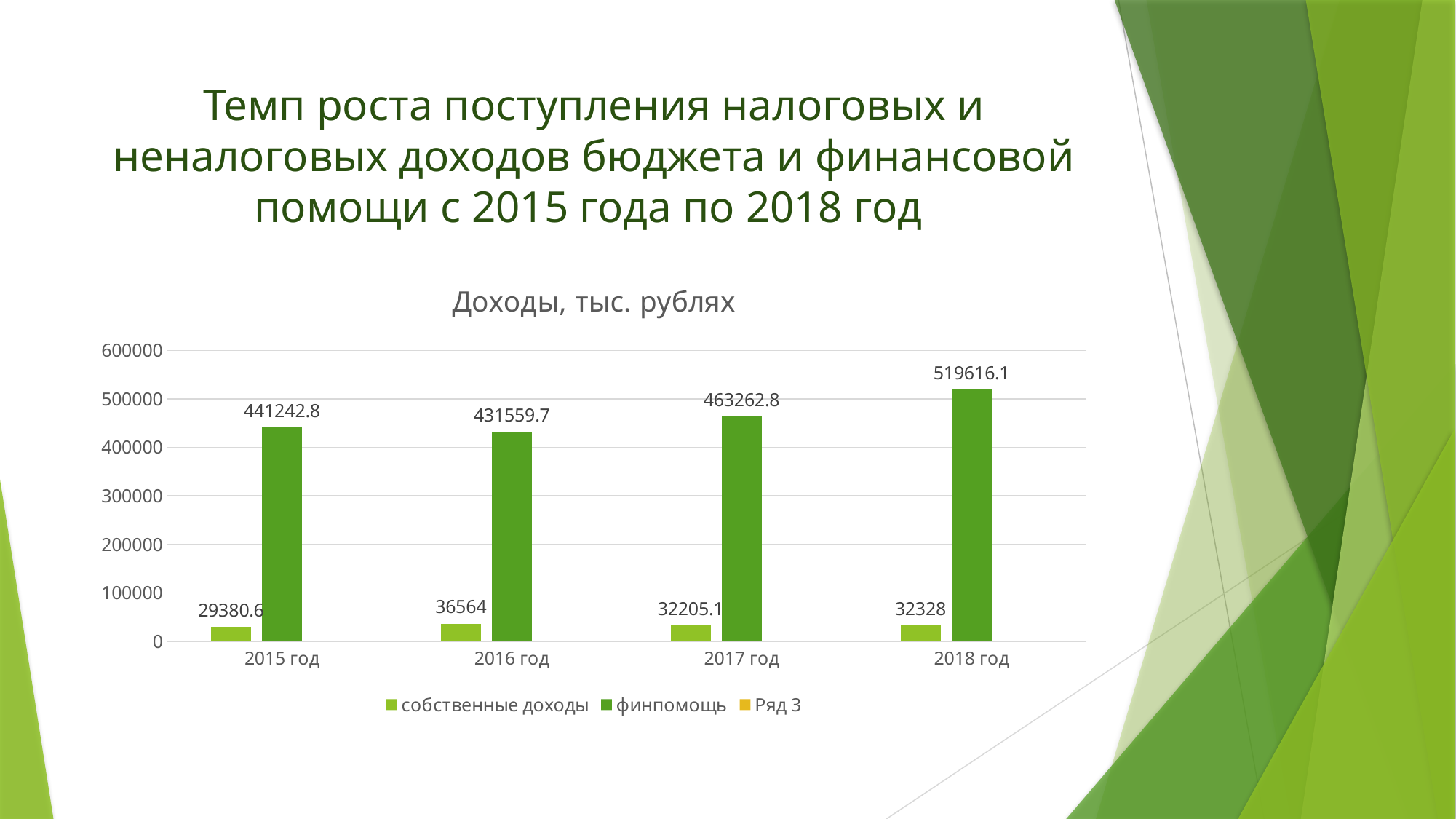
How many series does the legend list? 3 What type of chart is shown on the slide? bar chart What is the difference between финпомощь in 2018 год and 2015 год? 78373.3 What is the title of the chart? Доходы, тыс. рублях What is the value of собственные доходы for 2015 год? 29380.6 In which year is собственные доходы lowest? 2015 год Which is larger: собственные доходы in 2016 год or in 2015 год? 2016 год How many year categories are shown on the x axis? 4 What is the value of финпомощь for 2018 год? 519616.1 In which year is финпомощь highest? 2018 год What is the value of финпомощь for 2016 год? 431559.7 Is the value of финпомощь for 2018 год greater or less than 500000? greater